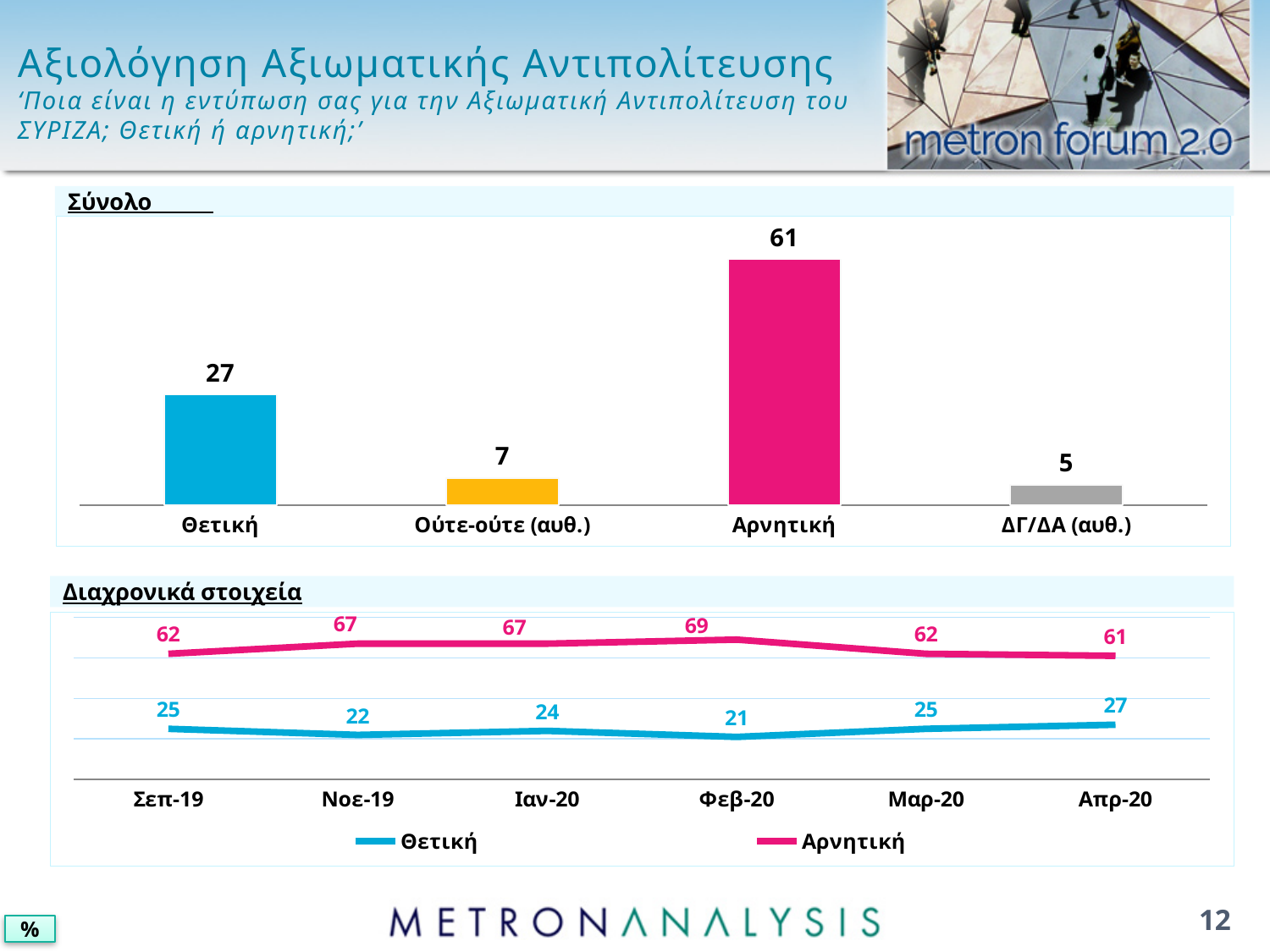
In the 'Σύνολο' bar chart, what is the difference between Αρνητική and Θετική? 34 In the 'Σύνολο' bar chart, which category has the lowest value? ΔΓ/ΔΑ (αυθ.) In the 'Διαχρονικά στοιχεία' line chart, in which period is Θετική lowest? Φεβ-20 In the 'Διαχρονικά στοιχεία' line chart, what is the difference between Αρνητική and Θετική in Σεπ-19? 37 In the 'Διαχρονικά στοιχεία' line chart, what is the value for Θετική in Νοε-19? 22 What kind of chart is the 'Σύνολο' chart? Bar chart In the 'Διαχρονικά στοιχεία' line chart, how many series does the legend list? 2 In the 'Διαχρονικά στοιχεία' line chart, does the Αρνητική series rise or fall from Φεβ-20 to Απρ-20? Fall In the 'Σύνολο' bar chart, how many categories are shown? 4 In the 'Διαχρονικά στοιχεία' line chart, what is the value for Αρνητική in Φεβ-20? 69 In the 'Σύνολο' bar chart, what is the value for Θετική? 27 In the 'Σύνολο' bar chart, what is the value for Αρνητική? 61